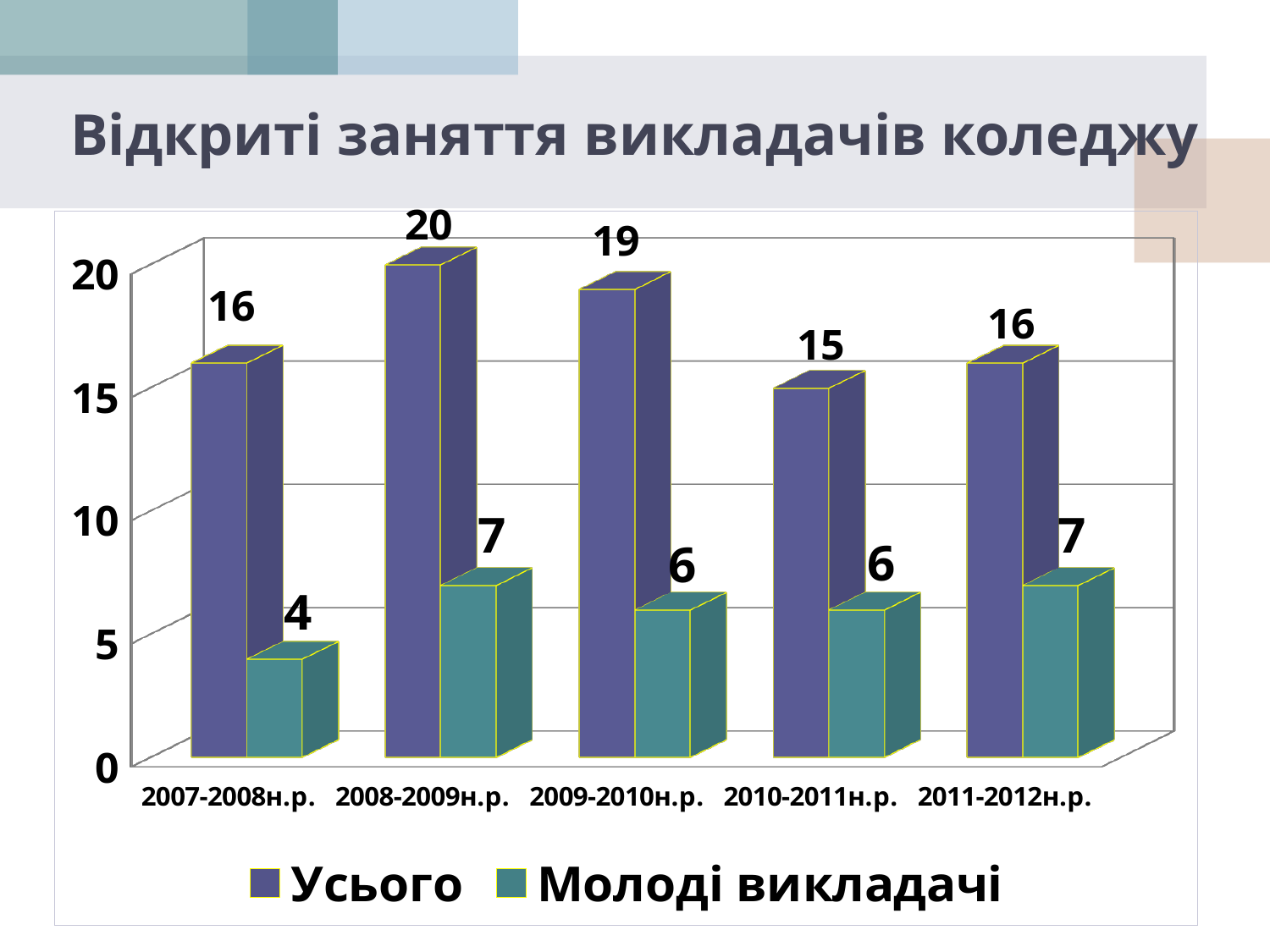
What is the value for Усього in 2008-2009н.р.? 20 What kind of chart is shown on the slide? bar chart What is the value for Молоді викладачі in 2007-2008н.р.? 4 Which year has the highest value for Усього? 2008-2009н.р. What is the value for Усього in 2010-2011н.р.? 15 Which year has the lowest value for Молоді викладачі? 2007-2008н.р. How many academic years are shown on the x axis? 5 How many series does the legend list? 2 What is the title of the slide? Відкриті заняття викладачів коледжу What is the difference between Усього and Молоді викладачі in 2009-2010н.р.? 13 What is the difference between Усього in 2008-2009н.р. and Усього in 2010-2011н.р.? 5 Which is larger: Молоді викладачі in 2008-2009н.р. or in 2010-2011н.р.? 2008-2009н.р.